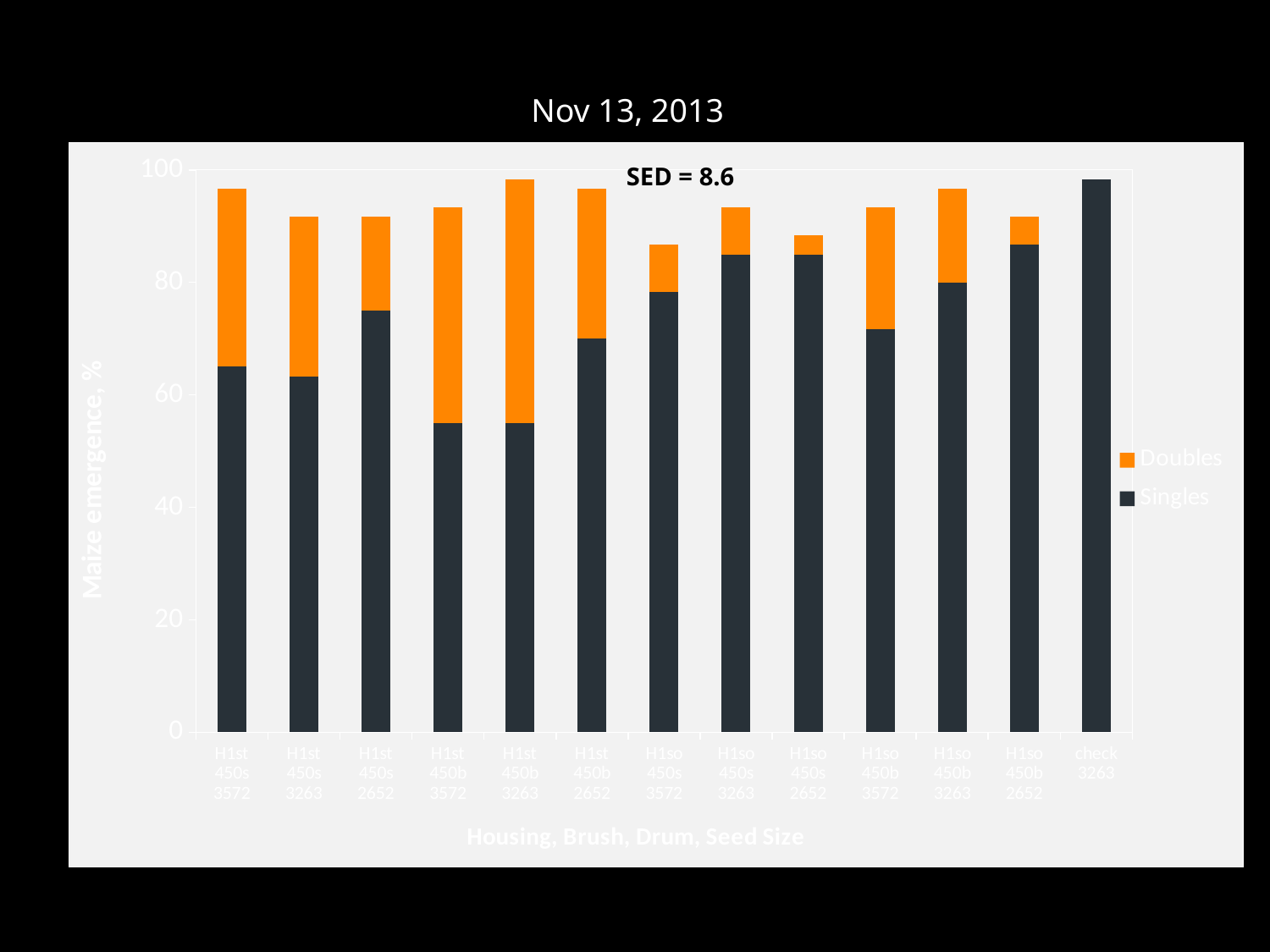
What SED value is printed on the chart? SED = 8.6 Which category shows no Doubles segment? check 3263 What is the title of the chart? Nov 13, 2013 Which category has the largest Doubles segment? H1st 450b 3263 What kind of chart is shown on the slide? Stacked bar chart Is the Singles value for H1so 450b 2652 greater or less than 80? greater How many series does the legend list? 2 Is the Singles value for H1st 450b 3572 greater or less than 60? less How many categories are plotted along the x axis? 13 Is the Singles value for H1st 450s 2652 greater or less than 80? less Which has the larger Singles value, check 3263 or H1st 450b 3263? check 3263